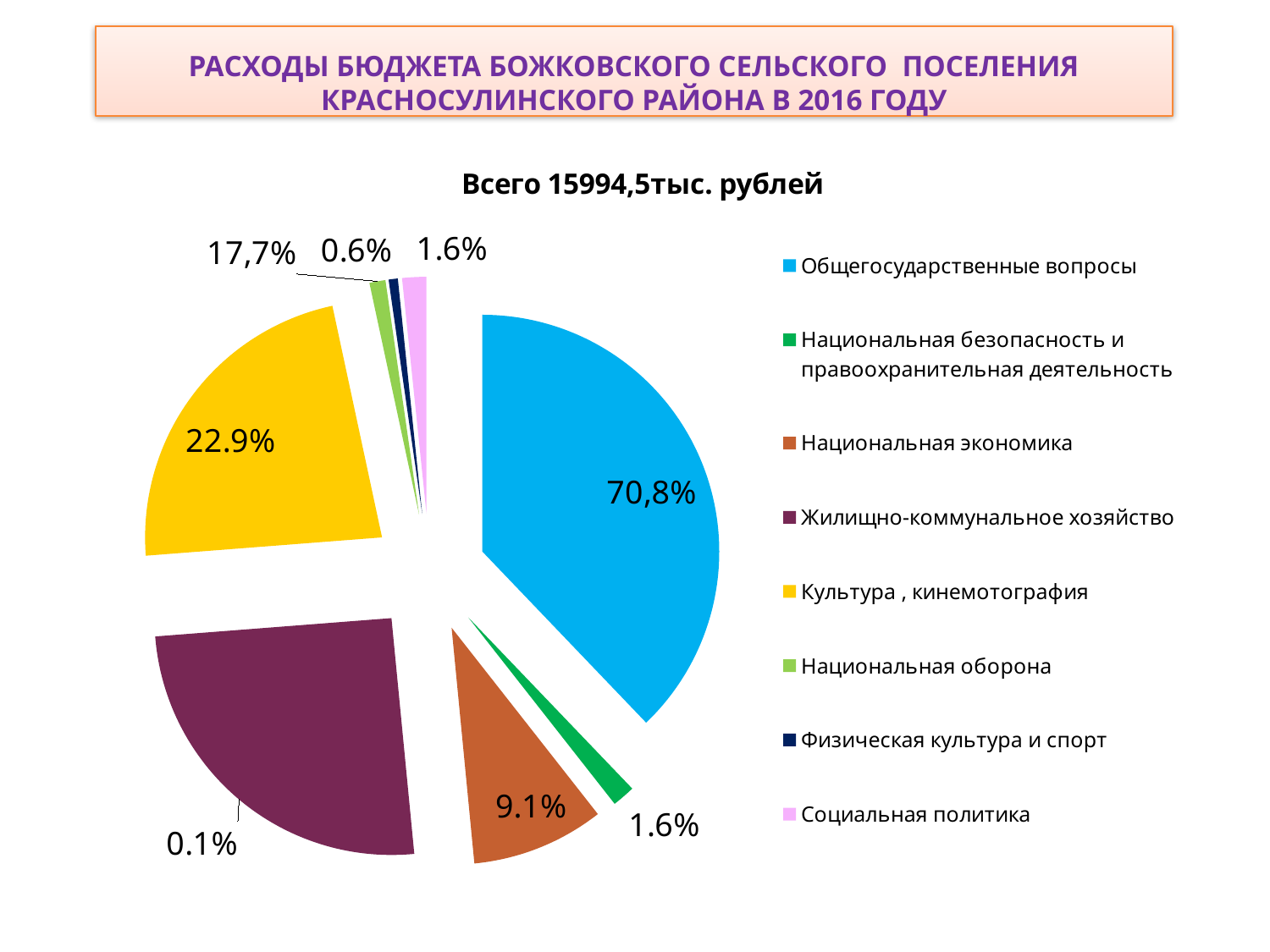
What percentage label is printed on the Общегосударственные вопросы slice? 70,8% What colour is used for the Социальная политика slice in the legend? Light pink What is the difference in percentage points between the labels on the Культура, кинемотография slice and the Национальная экономика slice? 13.8 percentage points Which slice is larger: Культура, кинемотография or Национальная экономика? Культура, кинемотография What type of chart is shown on the slide? Pie chart What total amount is stated in the chart title above the pie? Всего 15994,5тыс. рублей How many expenditure categories does the legend of the pie chart list? 8 Which slice is larger: Общегосударственные вопросы or Национальная экономика? Общегосударственные вопросы Which category has the largest slice of the pie? Общегосударственные вопросы What percentage label is printed on the Культура, кинемотография slice? 22.9% What percentage label is printed on the Национальная экономика slice? 9.1%